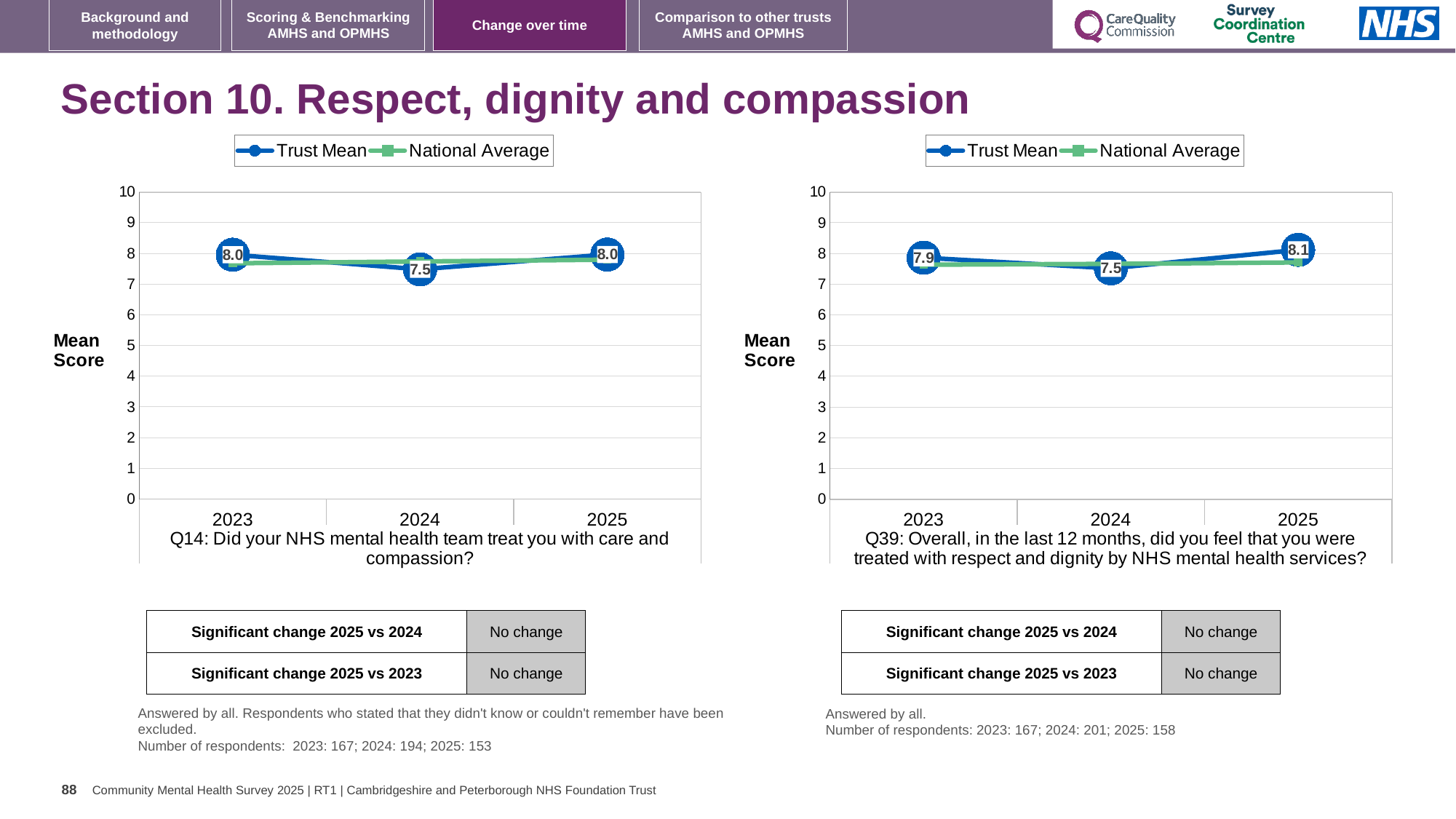
On the Q14 chart (left), what is the Trust Mean score for 2025? 8.0 On the Q39 chart (right), what is the Trust Mean score for 2025? 8.1 On the Q39 chart (right), is the Trust Mean score for 2025 larger or smaller than the Trust Mean score for 2024? larger On the Q14 chart (left), what is the difference between the Trust Mean scores for 2025 and 2024? 0.5 On the Q39 chart (right), which year has the lowest Trust Mean score? 2024 On the Q39 chart (right), what is the Trust Mean score for 2023? 7.9 What kind of chart is the Q39 chart (right)? line chart On the Q14 chart (left), what is the Trust Mean score for 2024? 7.5 On the Q39 chart (right), what is the difference between the Trust Mean scores for 2025 and 2023? 0.2 On the Q14 chart (left), is the National Average for 2024 greater or less than 5? greater On the Q39 chart (right), which year has the highest Trust Mean score? 2025 How many series does the legend of the Q14 chart (left) list? 2